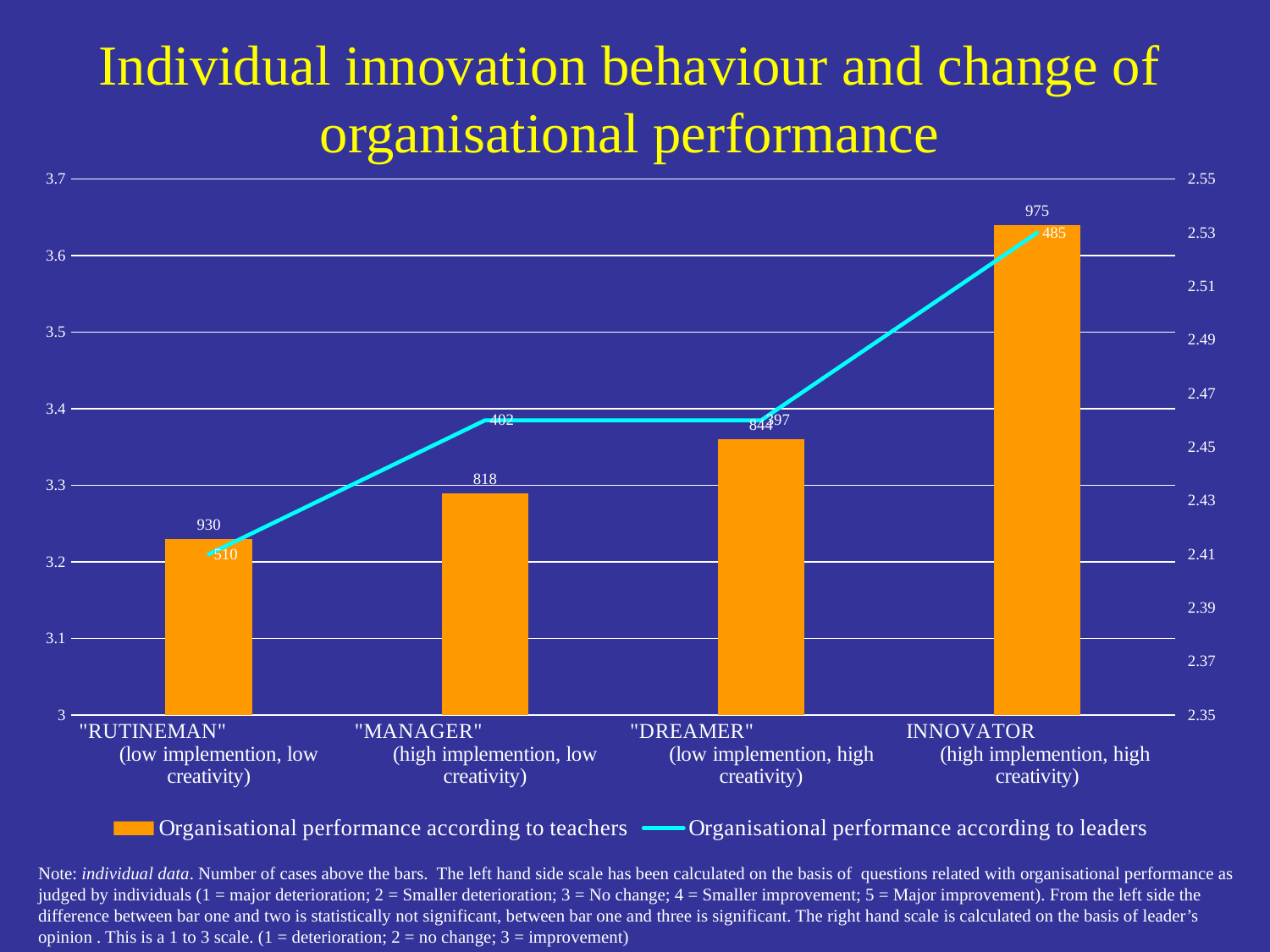
Is the bar for INNOVATOR (organisational performance according to teachers) greater or less than 3.6 on the left-hand scale? greater What number of cases is printed above the INNOVATOR bar? 975 How many series does the legend list? 2 Which category has the highest bar for organisational performance according to teachers? INNOVATOR What kind of chart is shown on the slide? A bar chart combined with a line chart Which bar is taller, "MANAGER" or "DREAMER"? "DREAMER" Is the bar for "RUTINEMAN" (organisational performance according to teachers) greater or less than 3.2 on the left-hand scale? greater How many categories are shown along the x axis? 4 Which category has the lowest bar for organisational performance according to teachers? "RUTINEMAN" Is the line value for INNOVATOR (organisational performance according to leaders) greater or less than 2.51 on the right-hand scale? greater Do the bars for organisational performance according to teachers rise or fall from left to right across the categories? rise